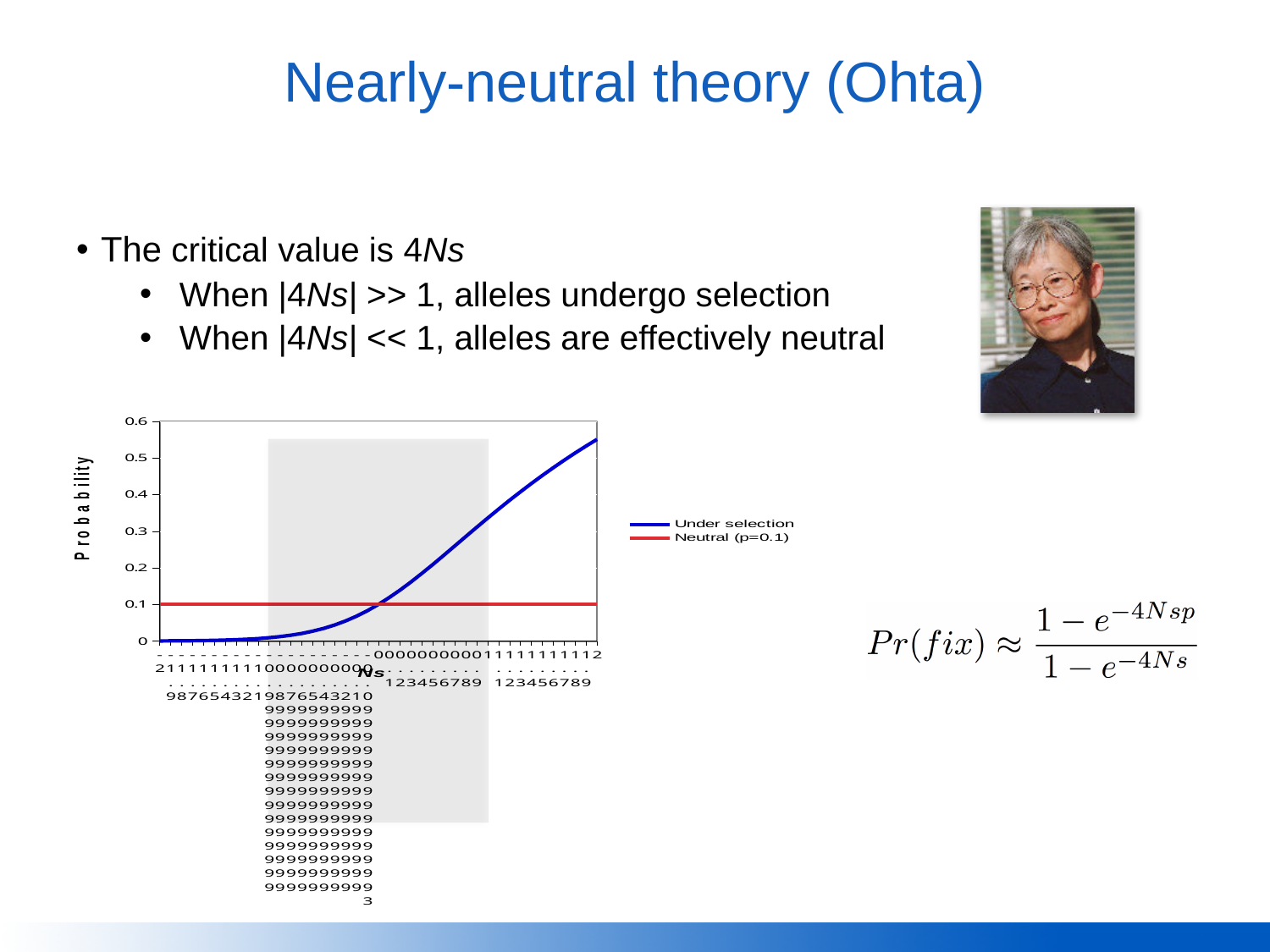
What are the two series named in the chart's legend? Under selection; Neutral (p=0.1) What is the highest tick value shown on the chart's y axis? 0.6 Is the value of the Neutral (p=0.1) line greater or less than 0.2? less What kind of chart is shown on the slide? line chart At the left end of the x axis, is the Under selection line greater or less than 0.1? less Does the Under selection line rise or fall as Ns increases along the x axis? rise What constant probability value does the Neutral (p=0.1) line sit at? 0.1 At the right end of the x axis, which series has the higher probability, Under selection or Neutral (p=0.1)? Under selection How many series does the chart's legend list? 2 At the left end of the x axis, which series has the higher probability, Under selection or Neutral (p=0.1)? Neutral (p=0.1) Is the highest value reached by the Under selection line greater or less than 0.5? greater What is the label on the chart's y axis? Probability